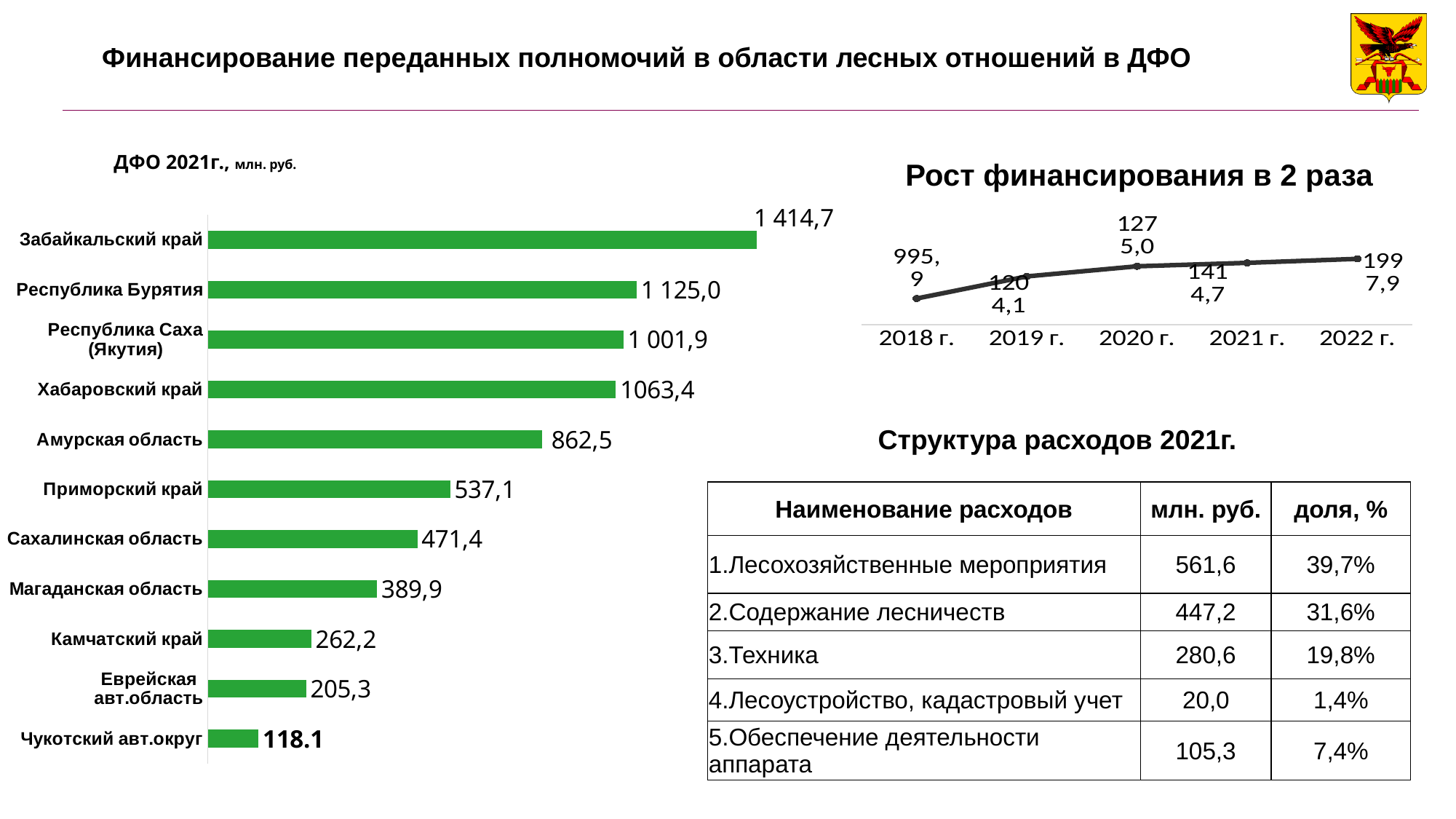
In the chart 'Рост финансирования в 2 раза', what is the value for 2018 г.? 995,9 What kind of chart is 'Рост финансирования в 2 раза'? line chart In the bar chart 'ДФО 2021г., млн. руб.', which region has the highest value? Забайкальский край How many regions are shown in the bar chart 'ДФО 2021г., млн. руб.'? 11 In the bar chart 'ДФО 2021г., млн. руб.', what is the difference between Приморский край and Сахалинская область? 65,7 In the chart 'Рост финансирования в 2 раза', do the values rise or fall from 2018 г. to 2022 г.? rise In the bar chart 'ДФО 2021г., млн. руб.', which region has the lowest value? Чукотский авт.округ In the bar chart 'ДФО 2021г., млн. руб.', what is the value for Амурская область? 862,5 How many years are plotted in the chart 'Рост финансирования в 2 раза'? 5 In the bar chart 'ДФО 2021г., млн. руб.', what is the value for Забайкальский край? 1 414,7 What kind of chart is 'ДФО 2021г., млн. руб.'? bar chart